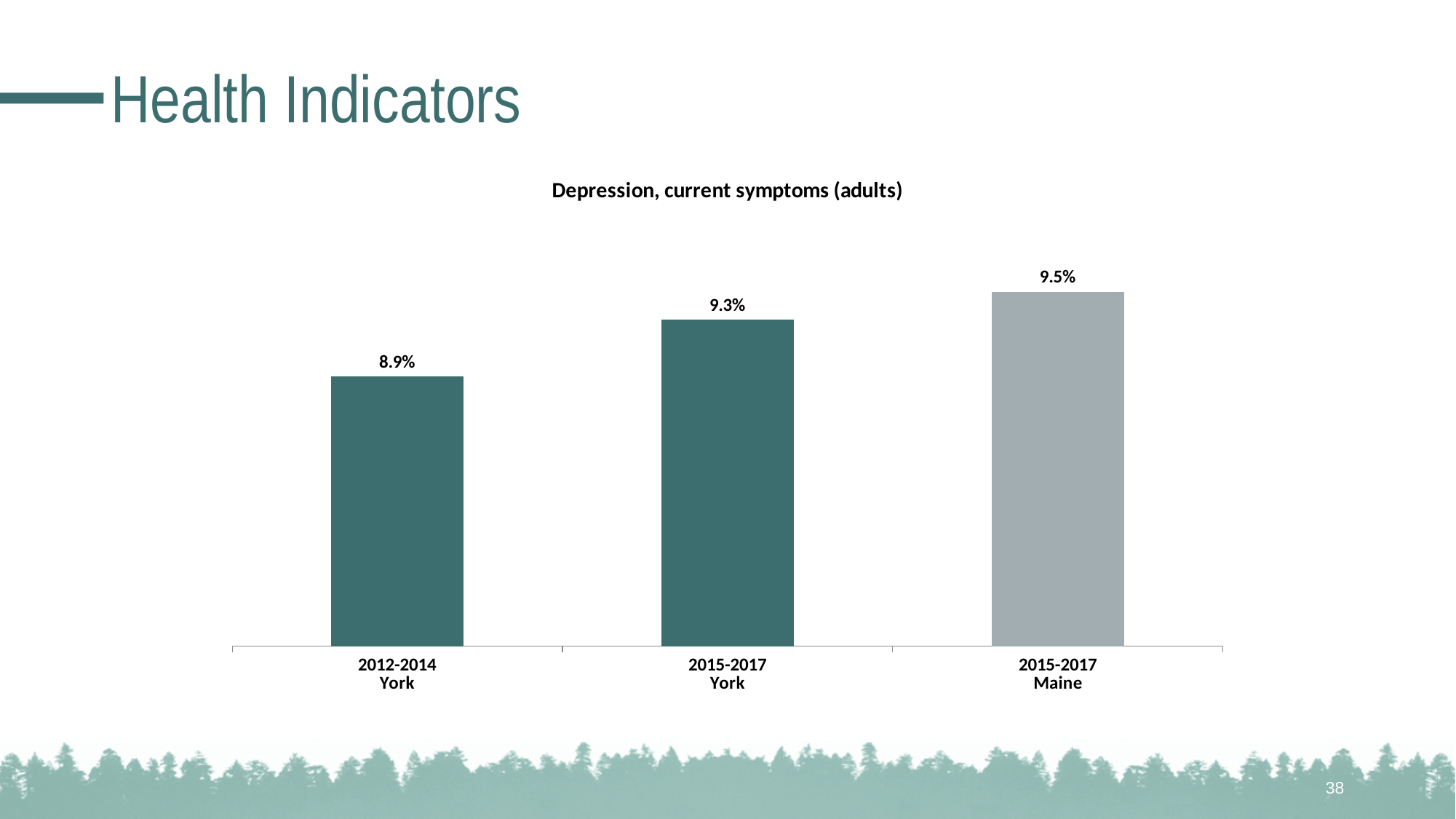
How many bars are shown in the chart? 3 What is the value for 2015-2017 York? 9.3% Which category has the lowest value? 2012-2014 York What is the title of the chart? Depression, current symptoms (adults) What is the value for 2015-2017 Maine? 9.5% What is the value for 2012-2014 York? 8.9% Which is larger, the value for 2015-2017 York or the value for 2012-2014 York? 2015-2017 York What is the difference between the 2015-2017 York value and the 2012-2014 York value? 0.4% Do the values rise or fall from left to right across the bars? Rise What kind of chart is shown on the slide? Bar chart Which category has the highest value? 2015-2017 Maine What is the difference between the 2015-2017 Maine value and the 2015-2017 York value? 0.2%